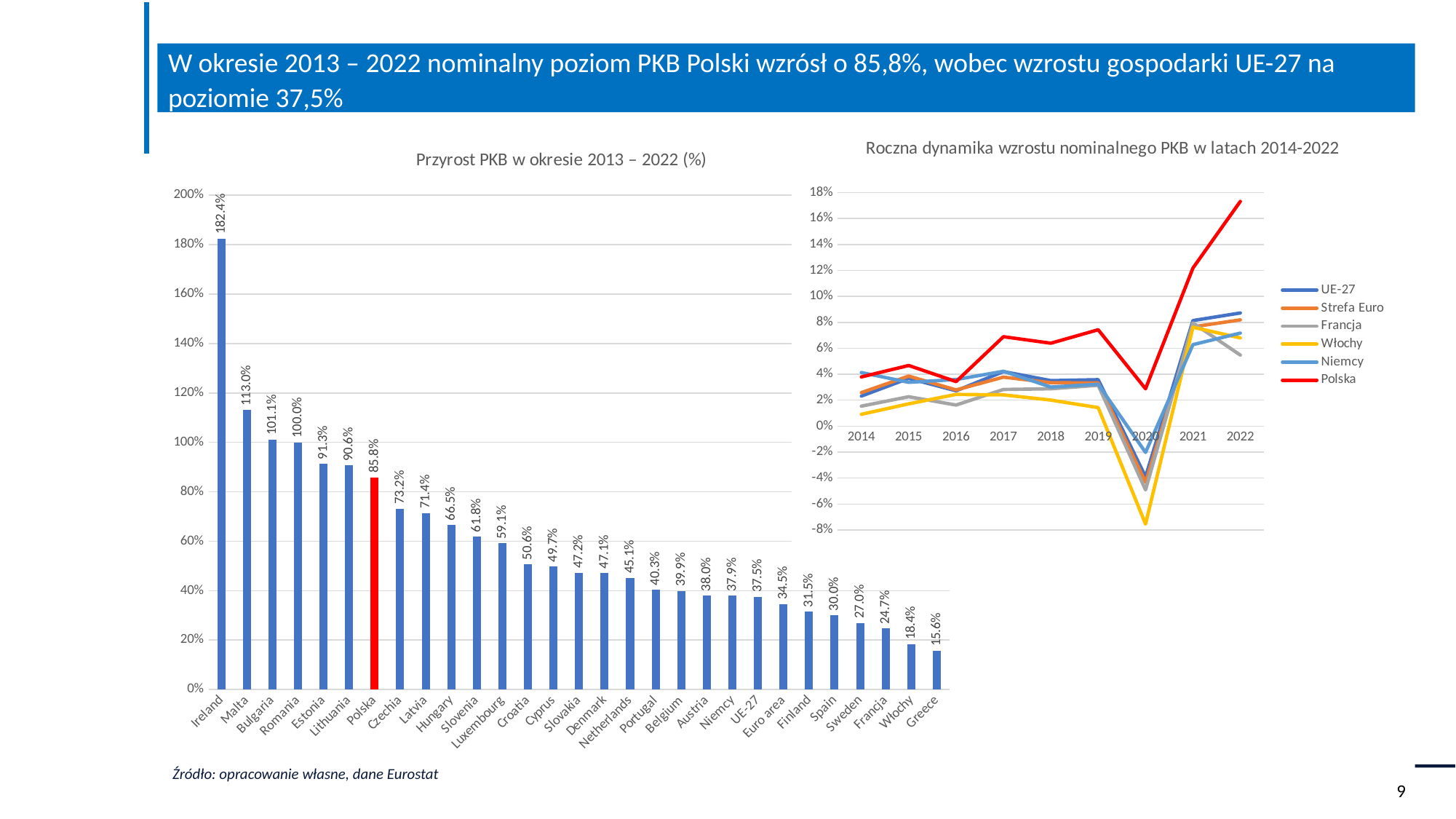
In the chart 'Przyrost PKB w okresie 2013 – 2022 (%)', which country has the lowest value? Greece In the chart 'Przyrost PKB w okresie 2013 – 2022 (%)', which country has the highest value? Ireland In the chart 'Przyrost PKB w okresie 2013 – 2022 (%)', which has a larger value, Czechia or Hungary? Czechia What kind of chart is 'Przyrost PKB w okresie 2013 – 2022 (%)'? Bar chart In the chart 'Przyrost PKB w okresie 2013 – 2022 (%)', how many bars are shown? 29 In the chart 'Roczna dynamika wzrostu nominalnego PKB w latach 2014-2022', which series has the lowest value in 2020? Włochy In the chart 'Roczna dynamika wzrostu nominalnego PKB w latach 2014-2022', is the value for Polska in 2022 greater or less than 16%? greater In the chart 'Przyrost PKB w okresie 2013 – 2022 (%)', what is the value for Polska? 85.8% In the chart 'Przyrost PKB w okresie 2013 – 2022 (%)', what is the value for UE-27? 37.5% In the chart 'Przyrost PKB w okresie 2013 – 2022 (%)', what is the difference between the values for Polska and UE-27? 48.3 percentage points In the chart 'Przyrost PKB w okresie 2013 – 2022 (%)', which bar is coloured red? Polska How many series does the legend of the chart 'Roczna dynamika wzrostu nominalnego PKB w latach 2014-2022' list? 6